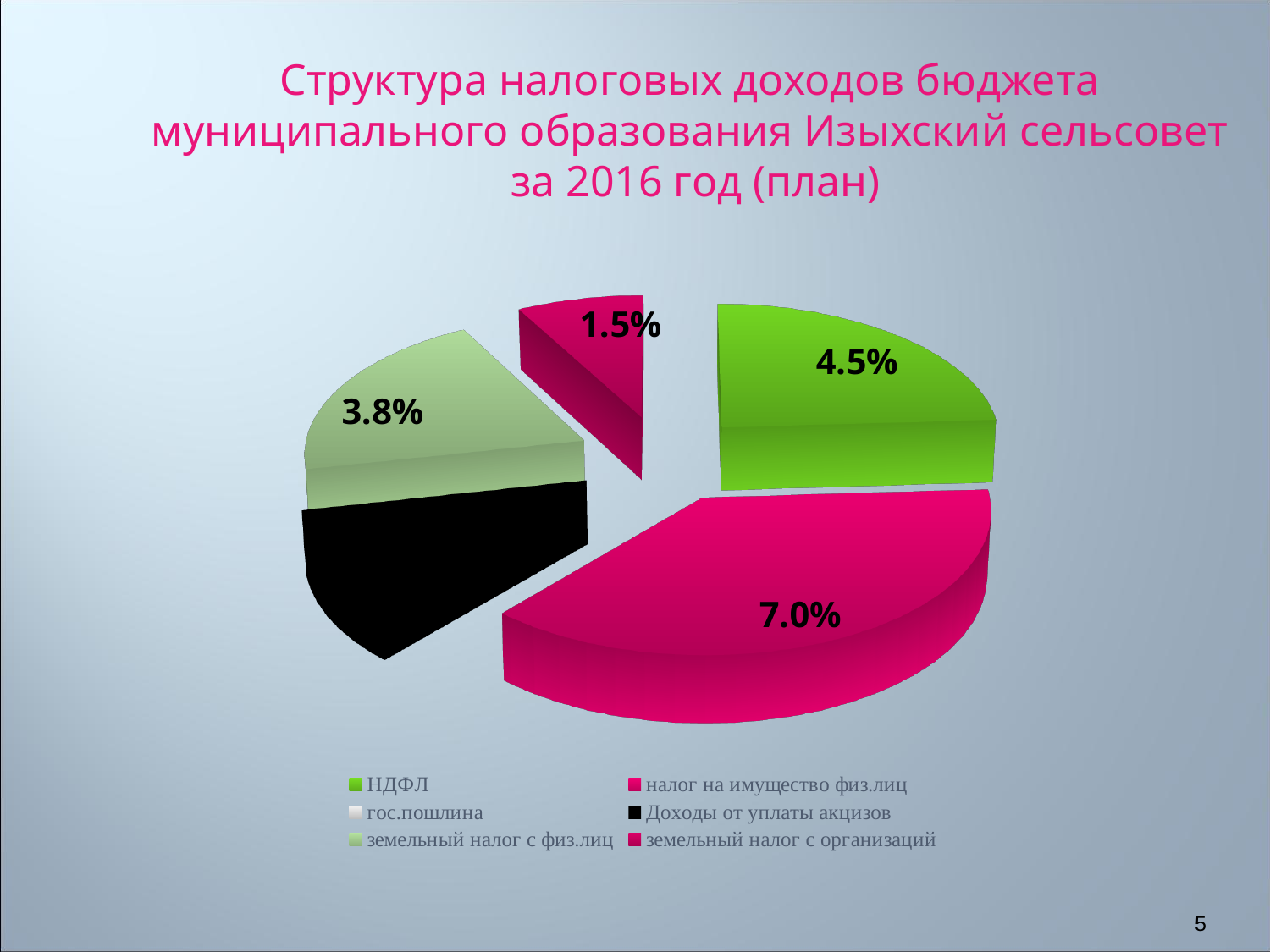
What percentage is shown for земельный налог с физ.лиц? 3.8% What percentage is shown for земельный налог с организаций? 1.5% What colour represents НДФЛ in the chart? Green What kind of chart is shown on the slide? Pie chart Which category has the largest slice of the pie chart? налог на имущество физ.лиц What percentage is shown for налог на имущество физ.лиц? 7.0% How many entries does the legend of the chart list? 6 Which is larger: the value for НДФЛ or the value for земельный налог с физ.лиц? НДФЛ What is the difference between the values for налог на имущество физ.лиц and НДФЛ? 2.5% What is the difference between the values for НДФЛ and земельный налог с физ.лиц? 0.7% What percentage is shown for НДФЛ on the pie chart? 4.5% Which is larger: the value for земельный налог с организаций or the value for земельный налог с физ.лиц? земельный налог с физ.лиц